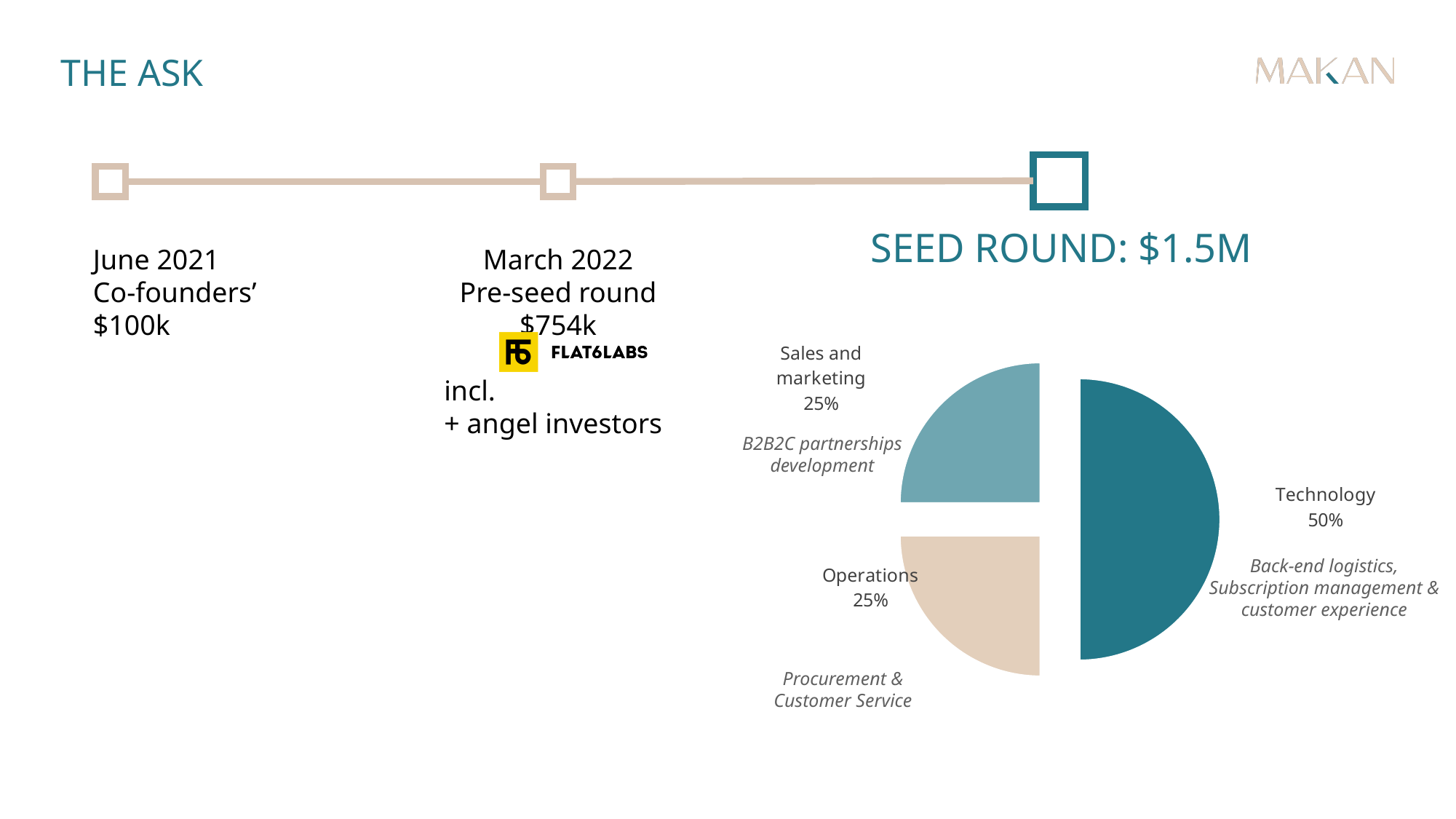
Which category has the largest slice of the pie chart? Technology What is the total size of the seed round shown above the pie chart? $1.5M What is the combined share of Sales and marketing and Operations? 50% Which slice of the pie chart is coloured dark teal? Technology Which slice is larger, Technology or Sales and marketing? Technology How many slices does the pie chart have? 3 What share of the seed round is allocated to Operations? 25% What share of the seed round is allocated to Technology? 50% What share of the seed round is allocated to Sales and marketing? 25% What kind of chart is shown on the slide? Pie chart What is the difference in percentage points between the Technology slice and the Operations slice? 25